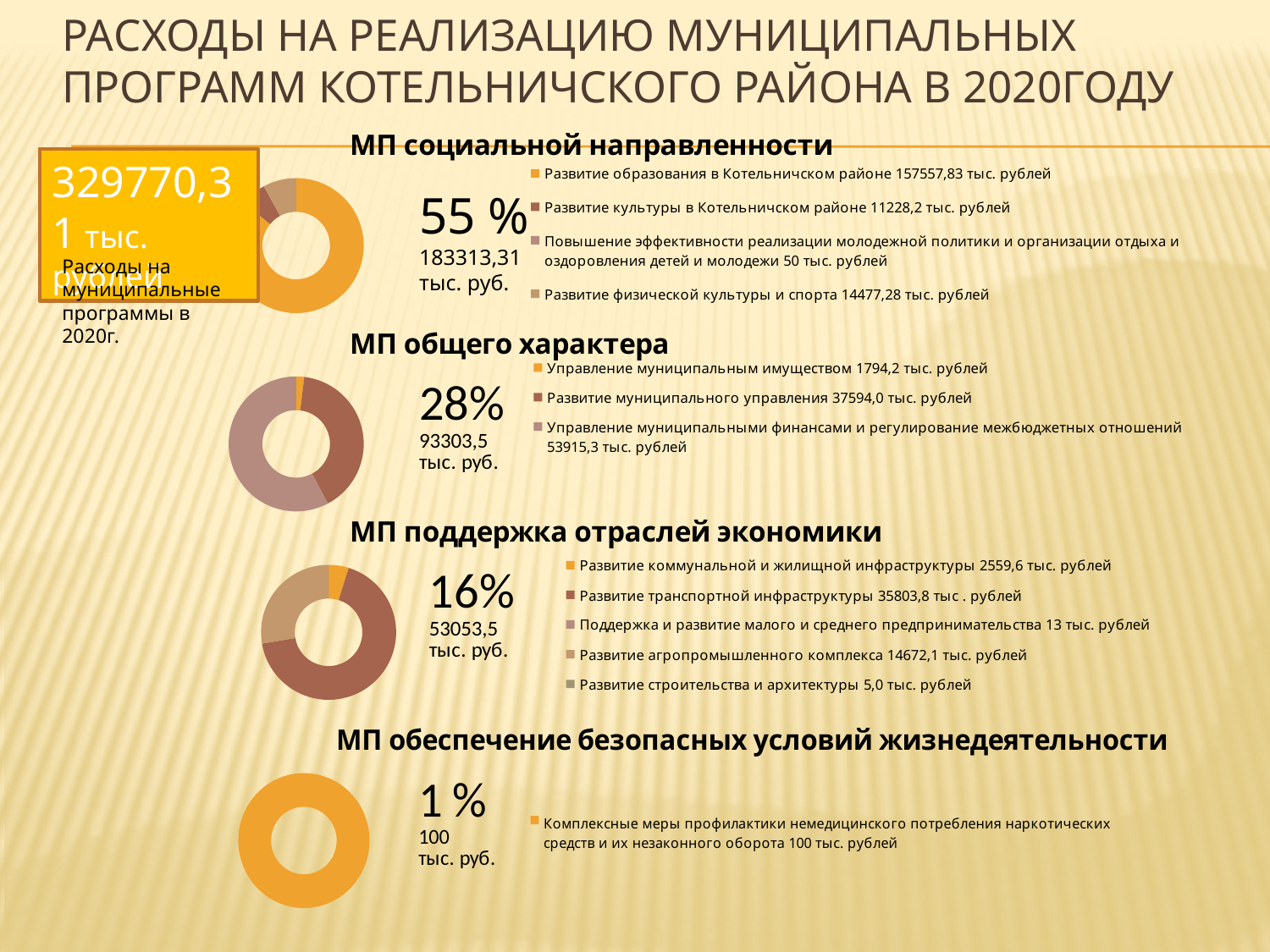
In the "МП социальной направленности" chart, which category has the lowest value? Повышение эффективности реализации молодежной политики и организации отдыха и оздоровления детей и молодежи In the "МП общего характера" chart, what is the value for "Развитие муниципального управления"? 37594,0 тыс. рублей In the "МП социальной направленности" chart, what is the value for "Развитие образования в Котельничском районе"? 157557,83 тыс. рублей In the "МП поддержка отраслей экономики" chart, which is larger: "Развитие транспортной инфраструктуры" or "Развитие агропромышленного комплекса"? Развитие транспортной инфраструктуры What kind of chart is used for "МП социальной направленности"? doughnut chart In the "МП поддержка отраслей экономики" chart, how many categories does the legend list? 5 What share of total expenditure does "МП обеспечение безопасных условий жизнедеятельности" represent, according to the slide? 1 % In the "МП поддержка отраслей экономики" chart, what is the value for "Развитие строительства и архитектуры"? 5,0 тыс. рублей What total is shown next to the "МП социальной направленности" chart? 183313,31 тыс. руб. In the "МП общего характера" chart, which category has the highest value? Управление муниципальными финансами и регулирование межбюджетных отношений In the "МП социальной направленности" chart, how many categories does the legend list? 4 In the "МП общего характера" chart, what is the difference between "Управление муниципальными финансами и регулирование межбюджетных отношений" and "Развитие муниципального управления"? 16321,3 тыс. рублей